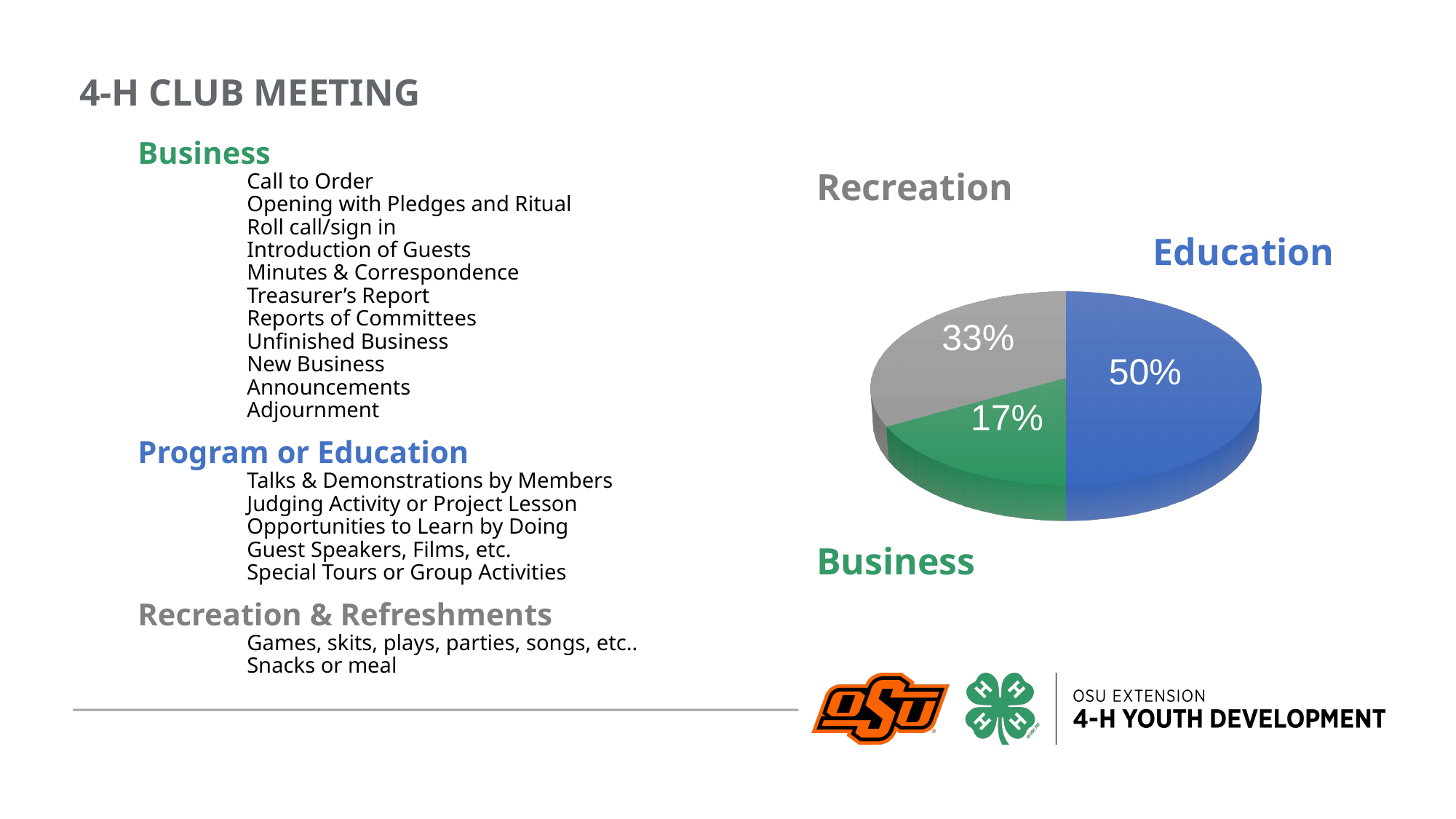
Which slice of the pie chart is the smallest? Business What is the difference in percentage points between the Education and Business slices? 33 How many slices does the pie chart have? 3 What colour is the Business slice of the pie chart? green What share of the pie chart is Education? 50% What kind of chart is shown on the slide? pie chart What share of the pie chart is Business? 17% What colour is the Education slice of the pie chart? blue Which is larger in the pie chart, Recreation or Business? Recreation What is the difference in percentage points between the Recreation and Business slices? 16 What share of the pie chart is Recreation? 33% Which slice of the pie chart is the largest? Education